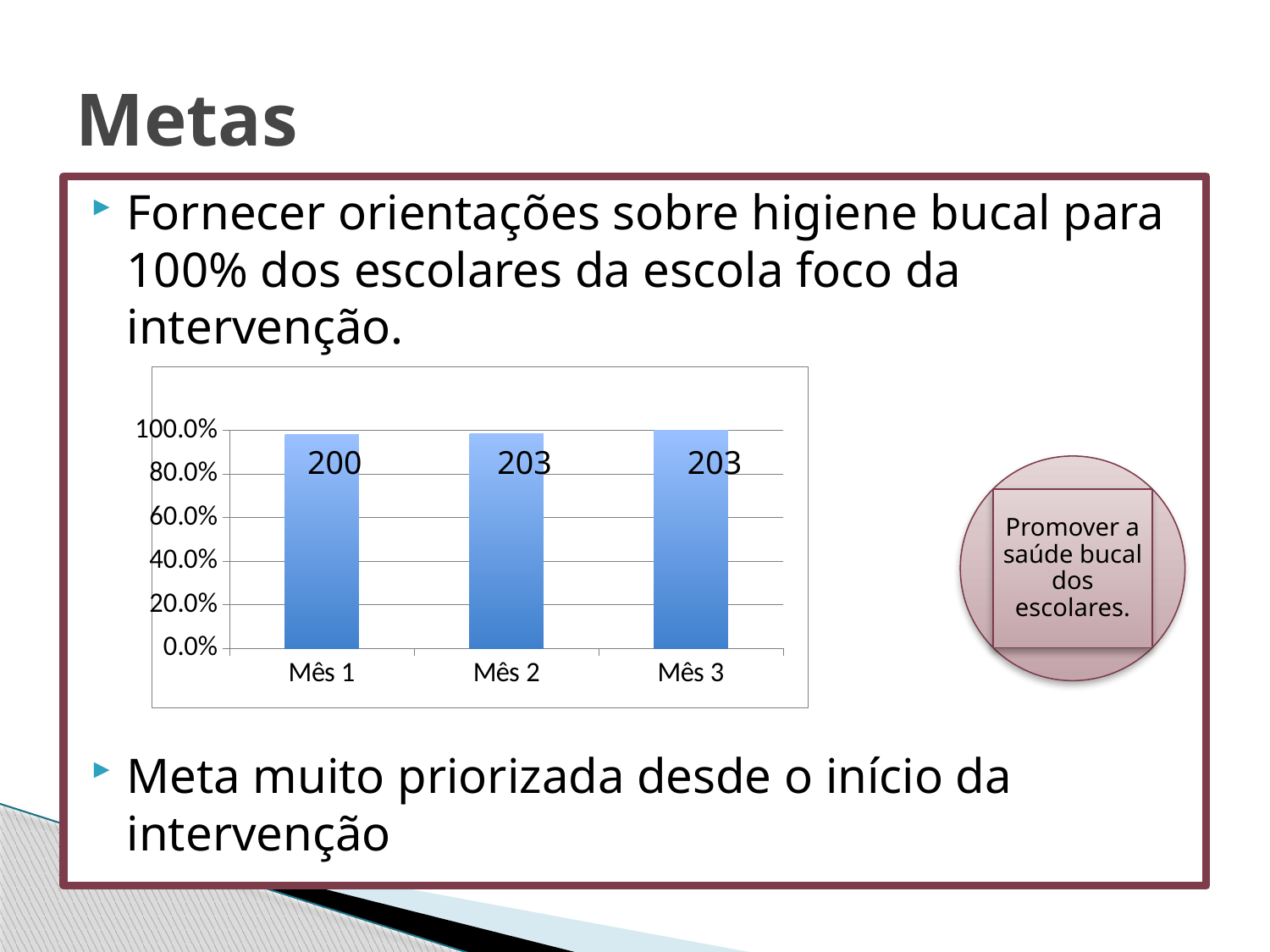
What is the data label on the bar for Mês 1? 200 What kind of chart is shown on the slide? bar chart Do the data labels rise or fall from Mês 1 to Mês 2? rise What is the highest tick label shown on the vertical axis? 100.0% Is the value for Mês 1 greater or less than 80.0%? greater What are the category labels on the horizontal axis? Mês 1, Mês 2, Mês 3 Which has the larger data label, Mês 1 or Mês 2? Mês 2 How many bars (categories) are plotted in the chart? 3 What is the data label on the bar for Mês 3? 203 What is the difference between the data labels for Mês 2 and Mês 1? 3 Is the value for Mês 3 greater or less than 60.0%? greater What is the data label on the bar for Mês 2? 203